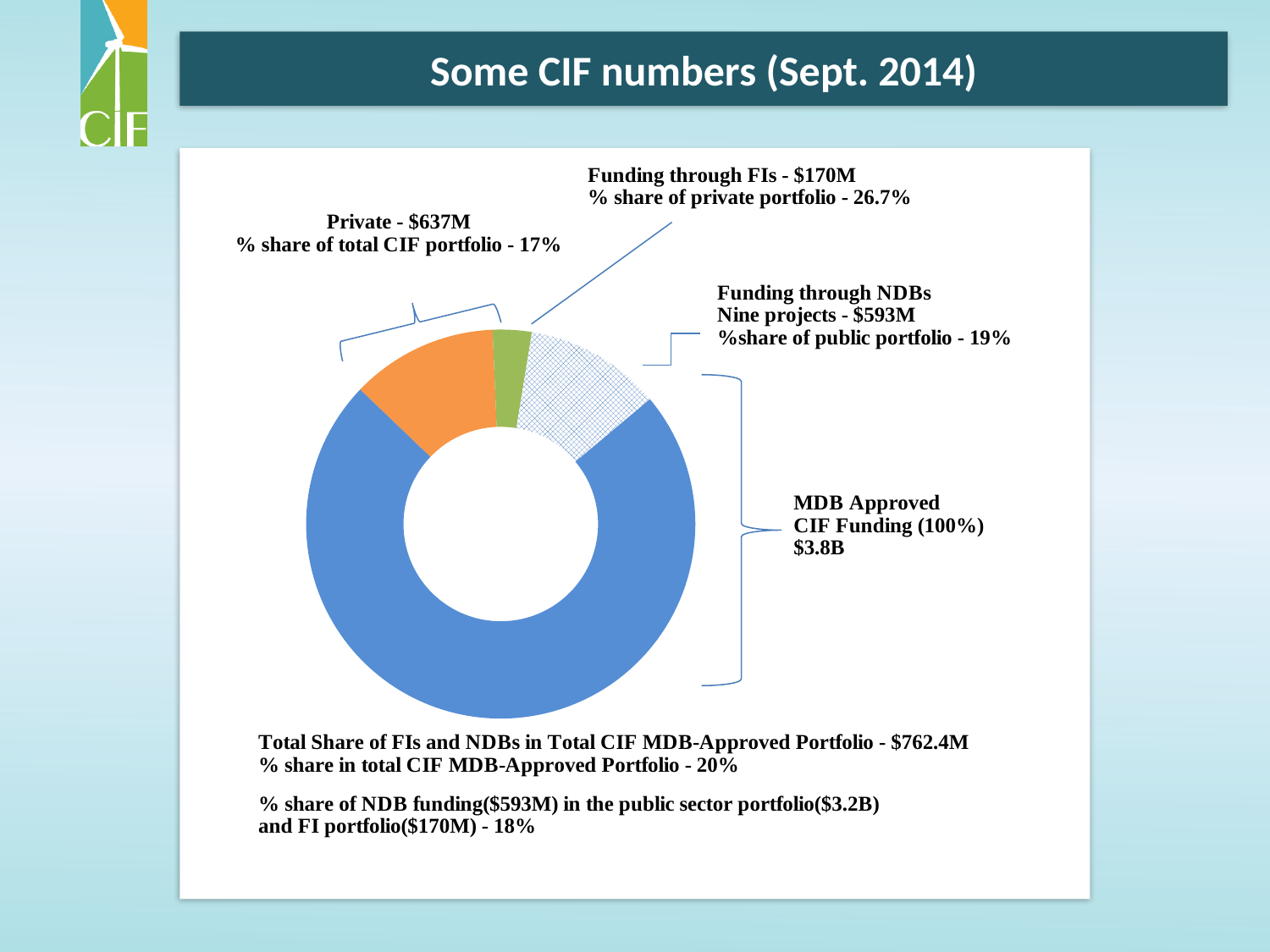
What is the amount of Funding through NDBs? $593M What percentage share of the total CIF portfolio is Private funding? 17% What kind of chart is shown on the slide? Doughnut (pie) chart What is the amount of Funding through FIs? $170M What is the total MDB Approved CIF Funding (100%)? $3.8B Which is larger, Funding through FIs or Funding through NDBs? Funding through NDBs What is the total share of FIs and NDBs in the total CIF MDB-Approved Portfolio? $762.4M How many segments does the doughnut chart have? 4 What percentage share of the public portfolio is Funding through NDBs? 19% What is the difference between Funding through NDBs ($593M) and Funding through FIs ($170M)? $423M What percentage share of the private portfolio is Funding through FIs? 26.7% What is the amount of Private funding shown on the chart? $637M